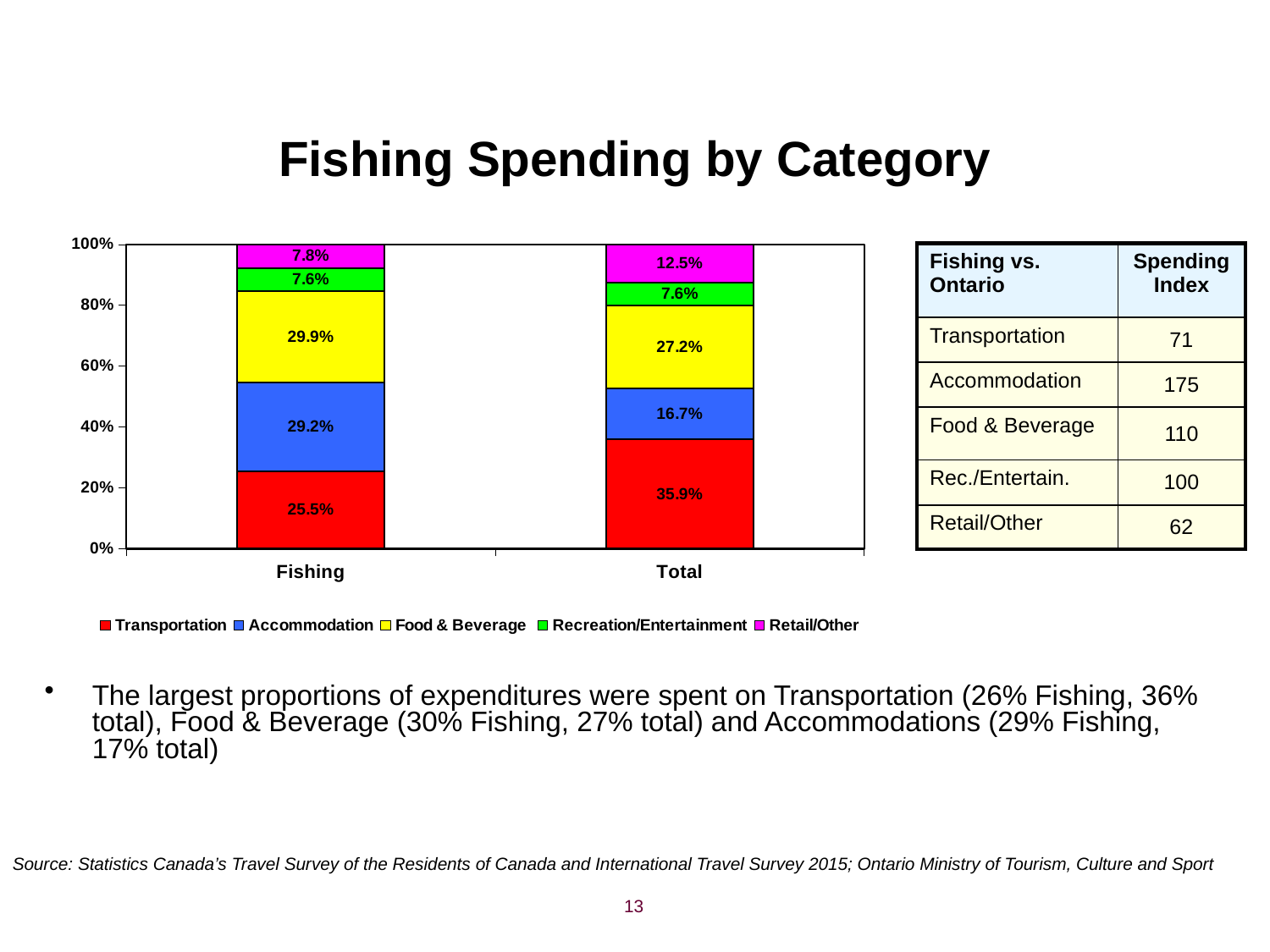
Which spending category has the smallest share in the Fishing bar? Recreation/Entertainment Is the Accommodation share larger for Fishing or for Total? Fishing What is the Accommodation share in the Total bar? 16.7% How many series does the legend list? 5 What is the Food & Beverage share in the Total bar? 27.2% How many bars are shown in the chart? 2 What percentage of Fishing spending goes to Transportation? 25.5% What type of chart is shown? Stacked bar chart How many percentage points higher is the Transportation share for Total than for Fishing? 10.4 What is the Retail/Other share for Fishing? 7.8% What colour represents Transportation in the chart? Red Which spending category has the largest share in the Total bar? Transportation